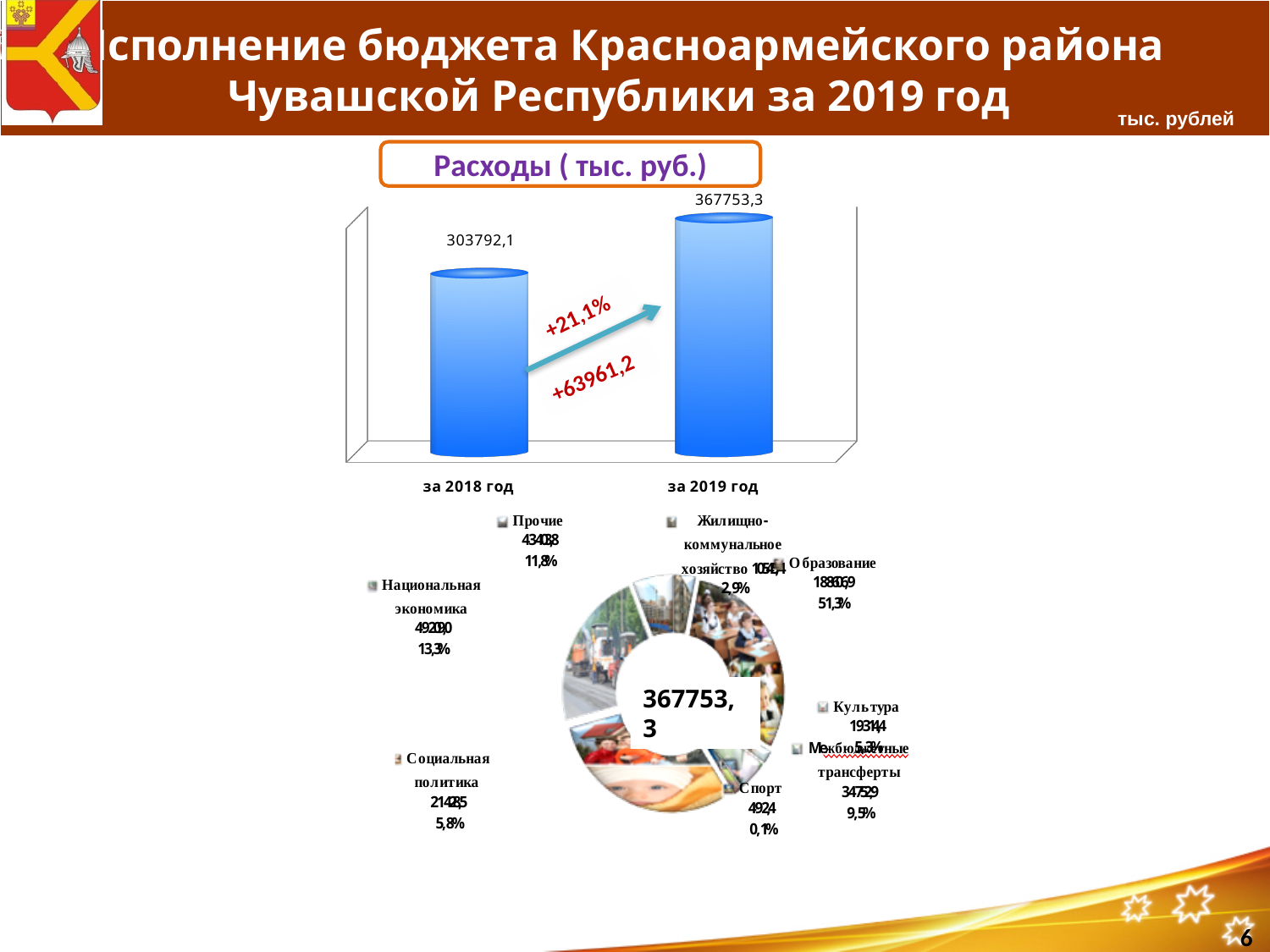
In the bar chart 'Расходы (тыс. руб.)', what percentage increase is shown on the arrow between 2018 and 2019? +21,1% In the bar chart 'Расходы (тыс. руб.)', by how much did the value increase from 2018 to 2019? 63961,2 What kind of chart is the upper chart 'Расходы (тыс. руб.)'? bar chart How many bars are shown in the bar chart 'Расходы (тыс. руб.)'? 2 In the pie chart at the bottom of the slide, what share does 'Образование' have? 51,3% In the pie chart at the bottom of the slide, which category has the largest share? Образование In the bar chart 'Расходы (тыс. руб.)', what is the value for 'за 2019 год'? 367753,3 In the bar chart 'Расходы (тыс. руб.)', which year has the higher value, 2018 or 2019? за 2019 год In the pie chart at the bottom of the slide, what share does 'Национальная экономика' have? 13,3% In the bar chart 'Расходы (тыс. руб.)', what is the value for 'за 2018 год'? 303792,1 What total value is printed in the centre of the pie chart at the bottom of the slide? 367753,3 In the pie chart at the bottom of the slide, which category has the smallest share? Спорт